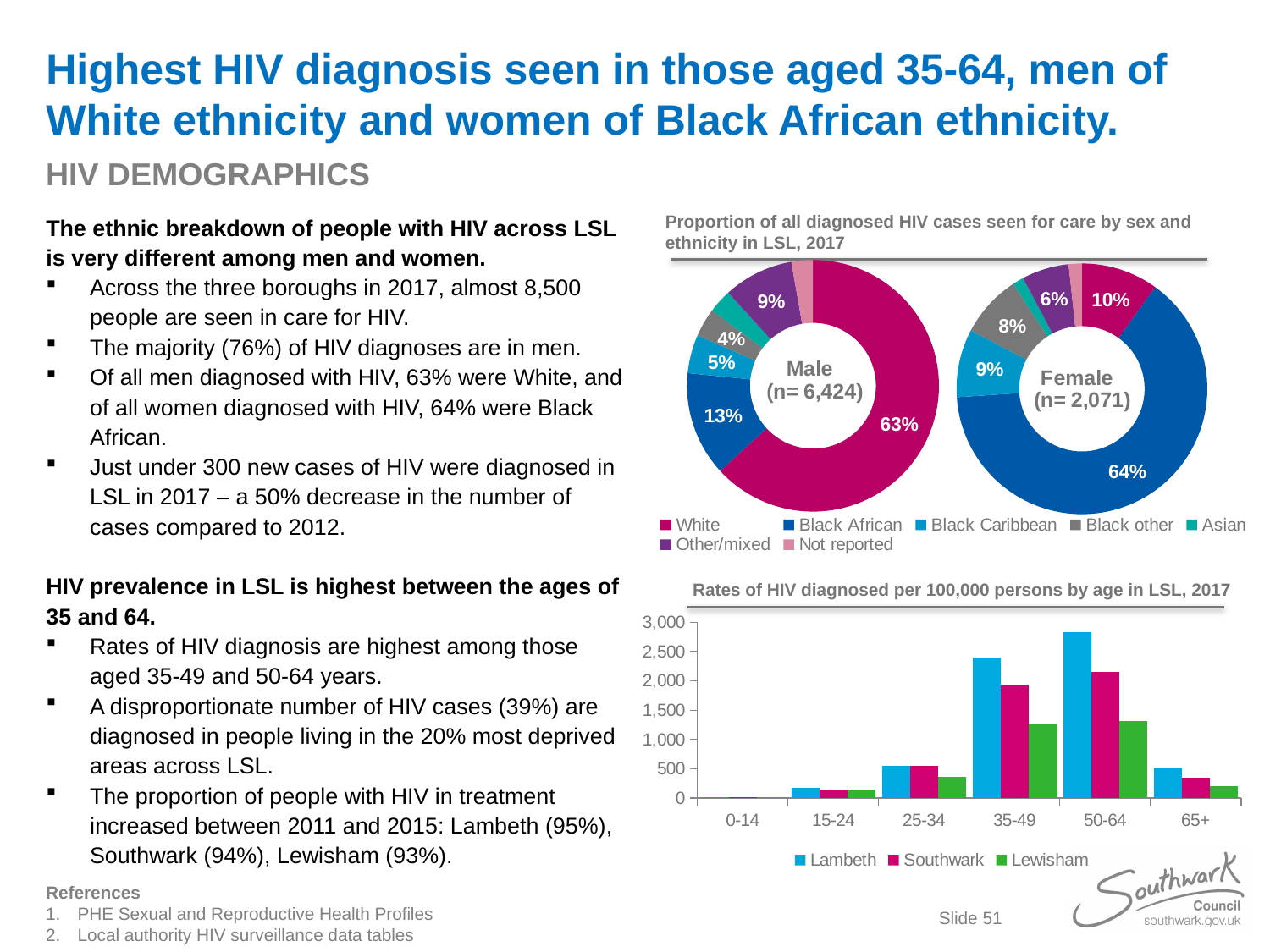
In the bar chart of HIV rates by age, is the value for Lambeth in the 50-64 age group greater or less than 2,500? greater In the bar chart of HIV rates by age, how many age groups are shown on the x axis? 6 In the donut chart of HIV cases by sex and ethnicity, what is the difference between the White share of male cases and the White share of female cases? 53% In the donut chart of HIV cases by sex and ethnicity, what is the number of male cases (n) shown in the centre of the Male donut? 6,424 In the bar chart of HIV rates by age, which borough has the higher rate in the 35-49 age group, Lambeth or Lewisham? Lambeth In the donut chart of HIV cases by sex and ethnicity, how many ethnicity categories does the legend list? 7 In the bar chart 'Rates of HIV diagnosed per 100,000 persons by age in LSL, 2017', which age group has the highest rate for Lambeth? 50-64 In the donut chart of HIV cases by sex and ethnicity, what percentage of male cases are Black African? 13% In the donut chart 'Proportion of all diagnosed HIV cases seen for care by sex and ethnicity in LSL, 2017', what percentage of male cases are White? 63% In the donut chart of HIV cases by sex and ethnicity, what percentage of female cases are Black African? 64% In the donut chart of HIV cases by sex and ethnicity, what percentage of female cases are White? 10%